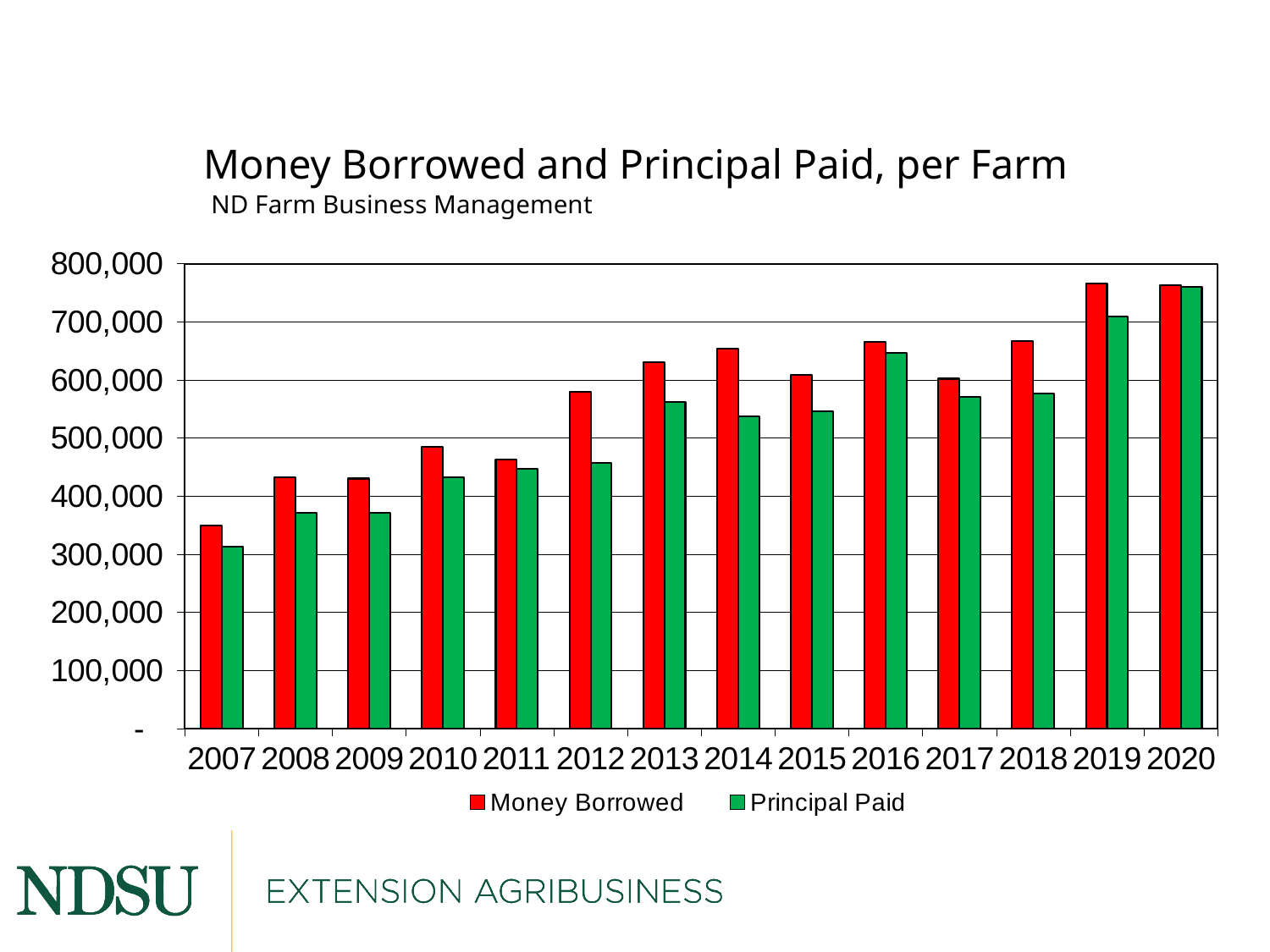
How many series does the legend list? 2 Which year has the lowest Principal Paid value? 2007 Which year has the highest Principal Paid value? 2020 Is the Money Borrowed value for 2012 greater or less than 500,000? greater Is the Money Borrowed value for 2007 greater or less than 400,000? less Is the Principal Paid value for 2011 greater or less than 500,000? less Which year has the lowest Money Borrowed value? 2007 How many years are shown on the x axis? 14 What kind of chart is shown on the slide? Bar chart Which colour represents Principal Paid in the legend? Green In 2013, which is larger: Money Borrowed or Principal Paid? Money Borrowed